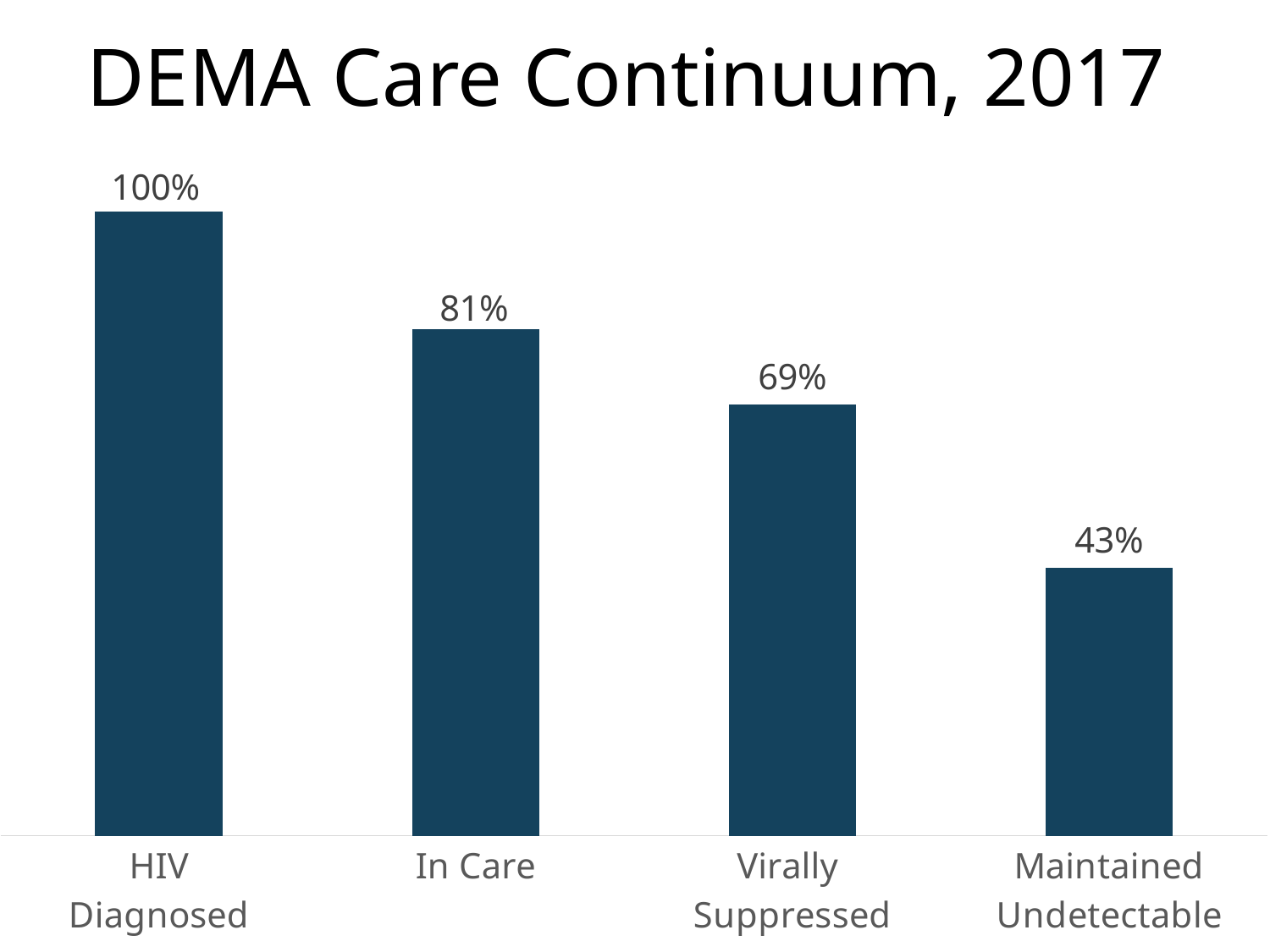
What kind of chart is shown on the slide? Bar chart How many categories are shown in the chart? 4 Which is larger, the value for In Care or the value for Maintained Undetectable? In Care Which category has the highest value? HIV Diagnosed What is the value for Maintained Undetectable? 43% What is the value for Virally Suppressed? 69% Which category has the lowest value? Maintained Undetectable What is the value for In Care? 81% What is the difference between the values for In Care and Virally Suppressed? 12% Do the values rise or fall from left to right along the x axis? Fall What is the value for HIV Diagnosed? 100% What is the difference between the values for Virally Suppressed and Maintained Undetectable? 26%